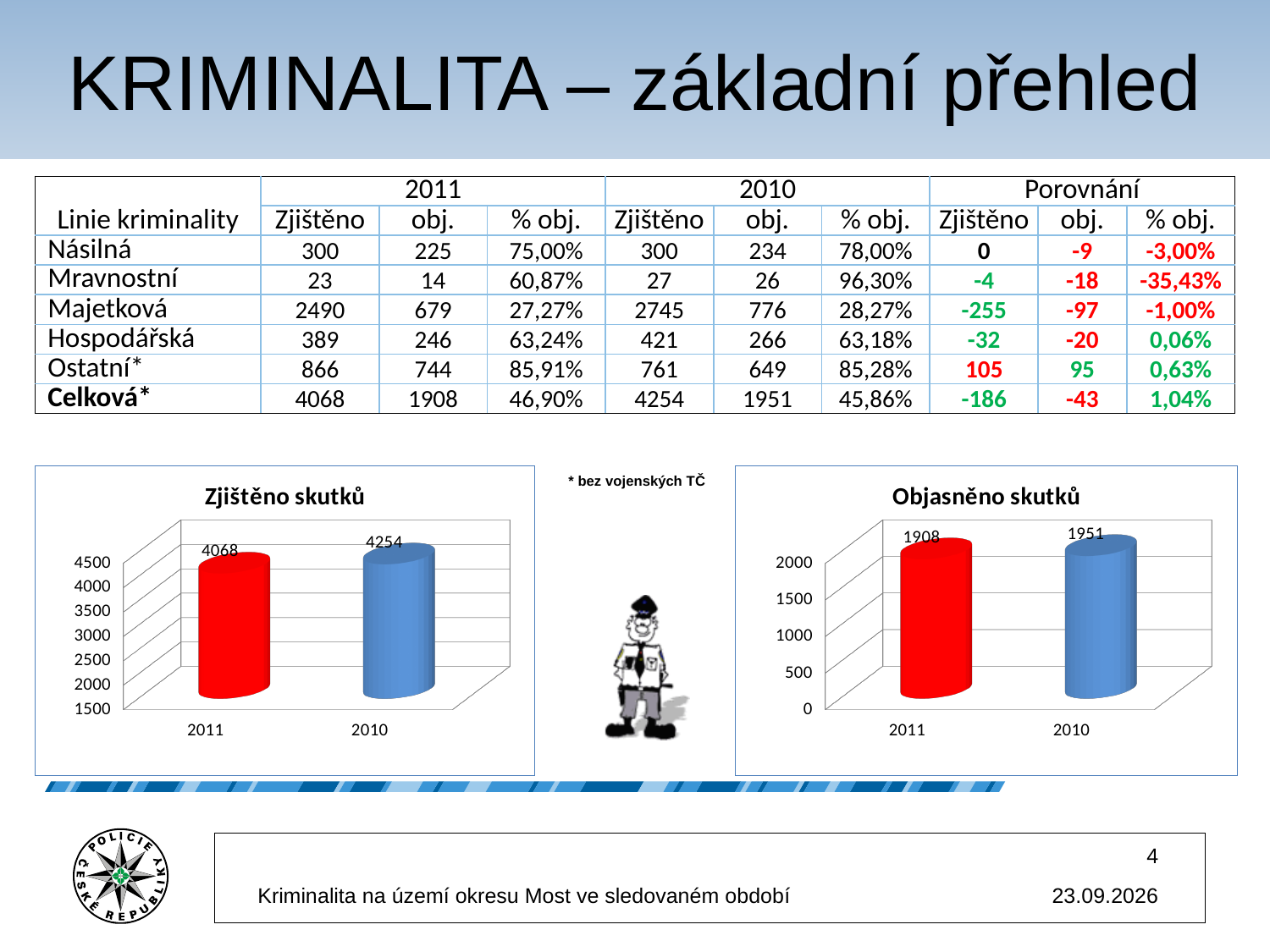
What kind of chart is the 'Objasněno skutků' chart? bar chart In the 'Objasněno skutků' chart, what is the value for 2010? 1951 In the 'Zjištěno skutků' chart, which year has the higher value? 2010 In the 'Objasněno skutků' chart, which year has the lower value? 2011 In the 'Zjištěno skutků' chart, what colour is the bar for 2011? red How many bars does the 'Zjištěno skutků' chart show? 2 In the 'Zjištěno skutků' chart, what is the value for 2010? 4254 In the 'Objasněno skutků' chart, what is the value for 2011? 1908 In the 'Zjištěno skutků' chart, what is the value for 2011? 4068 In the 'Objasněno skutků' chart, what is the difference between the 2010 and 2011 values? 43 In the 'Objasněno skutků' chart, is the value for 2011 greater or less than 1500? greater In the 'Zjištěno skutků' chart, what is the difference between the 2010 and 2011 values? 186